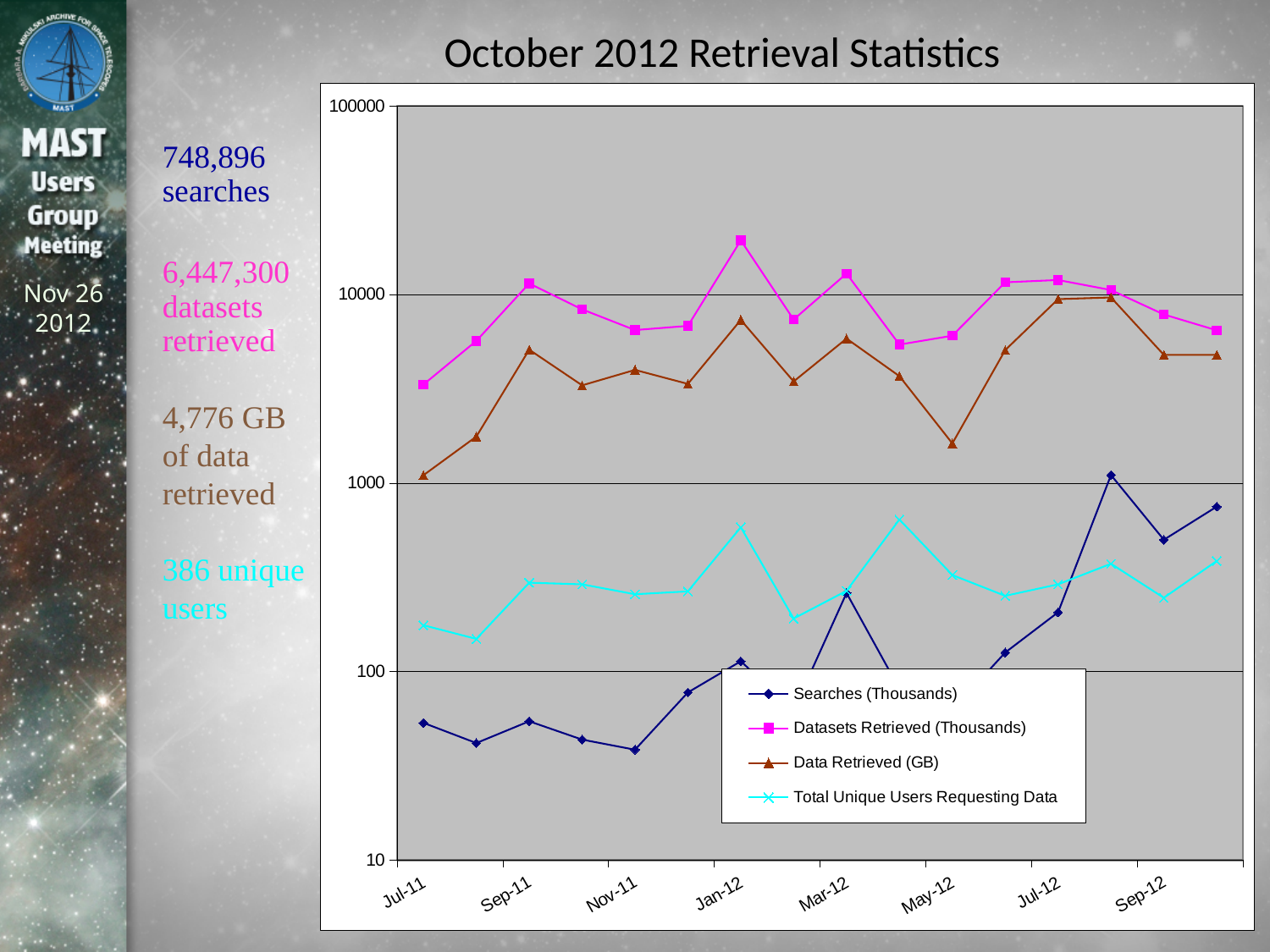
Is the value for Datasets Retrieved (Thousands) in Jan-12 greater or less than 10000? greater In Jan-12, which is larger: Datasets Retrieved (Thousands) or Data Retrieved (GB)? Datasets Retrieved (Thousands) How many series does the legend list? 4 Is the value for Data Retrieved (GB) in Apr-12 greater or less than 1000? greater Which series is drawn with the pink square markers? Datasets Retrieved (Thousands) What is the title of the chart? October 2012 Retrieval Statistics Does the Searches (Thousands) series generally rise or fall from Nov-11 to Aug-12? rise What kind of chart is shown on the slide? line chart How many monthly data points are plotted for each series? 16 In which month does the Searches (Thousands) series reach its highest value? Aug-12 In which month does the Datasets Retrieved (Thousands) series reach its highest value? Jan-12 Is the value for Searches (Thousands) in Jul-11 greater or less than 100? less